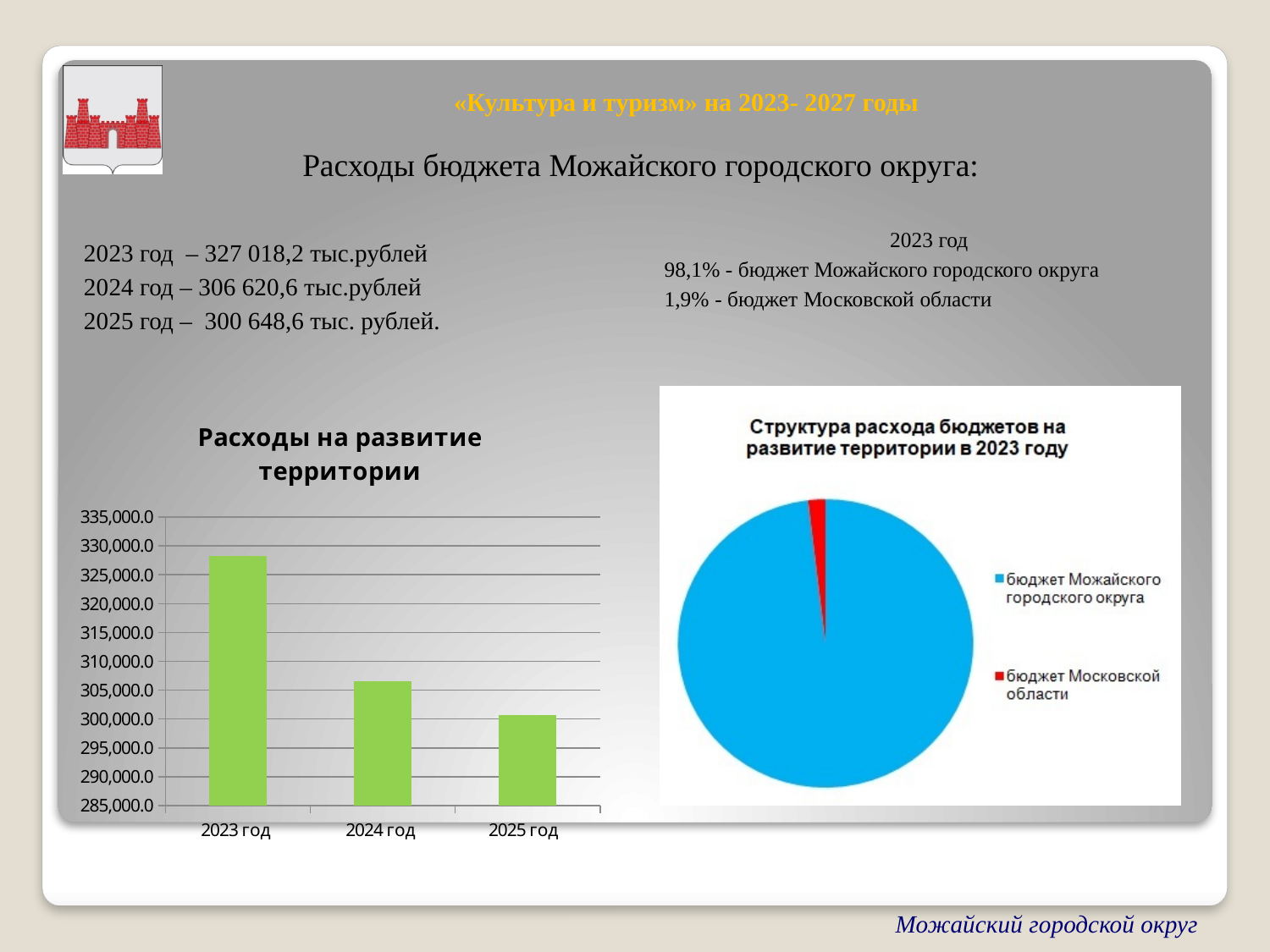
In the bar chart "Расходы на развитие территории", do the values rise or fall from 2023 год to 2025 год? fall What kind of chart is the chart titled "Расходы на развитие территории"? bar chart In the pie chart "Структура расхода бюджетов на развитие территории в 2023 году", how many entries does the legend list? 2 In the bar chart "Расходы на развитие территории", is the value for 2025 год greater or less than 305,000.0? less In the bar chart "Расходы на развитие территории", which year has the lowest bar? 2025 год In the bar chart "Расходы на развитие территории", is the value for 2024 год greater or less than 310,000.0? less What kind of chart is the chart titled "Структура расхода бюджетов на развитие территории в 2023 году"? pie chart In the bar chart "Расходы на развитие территории", how many bars are plotted? 3 In the bar chart "Расходы на развитие территории", which is larger, the value for 2024 год or the value for 2025 год? 2024 год In the bar chart "Расходы на развитие территории", is the value for 2023 год greater or less than 325,000.0? greater In the pie chart "Структура расхода бюджетов на развитие территории в 2023 году", which slice is the largest? бюджет Можайского городского округа In the bar chart "Расходы на развитие территории", which year has the highest bar? 2023 год